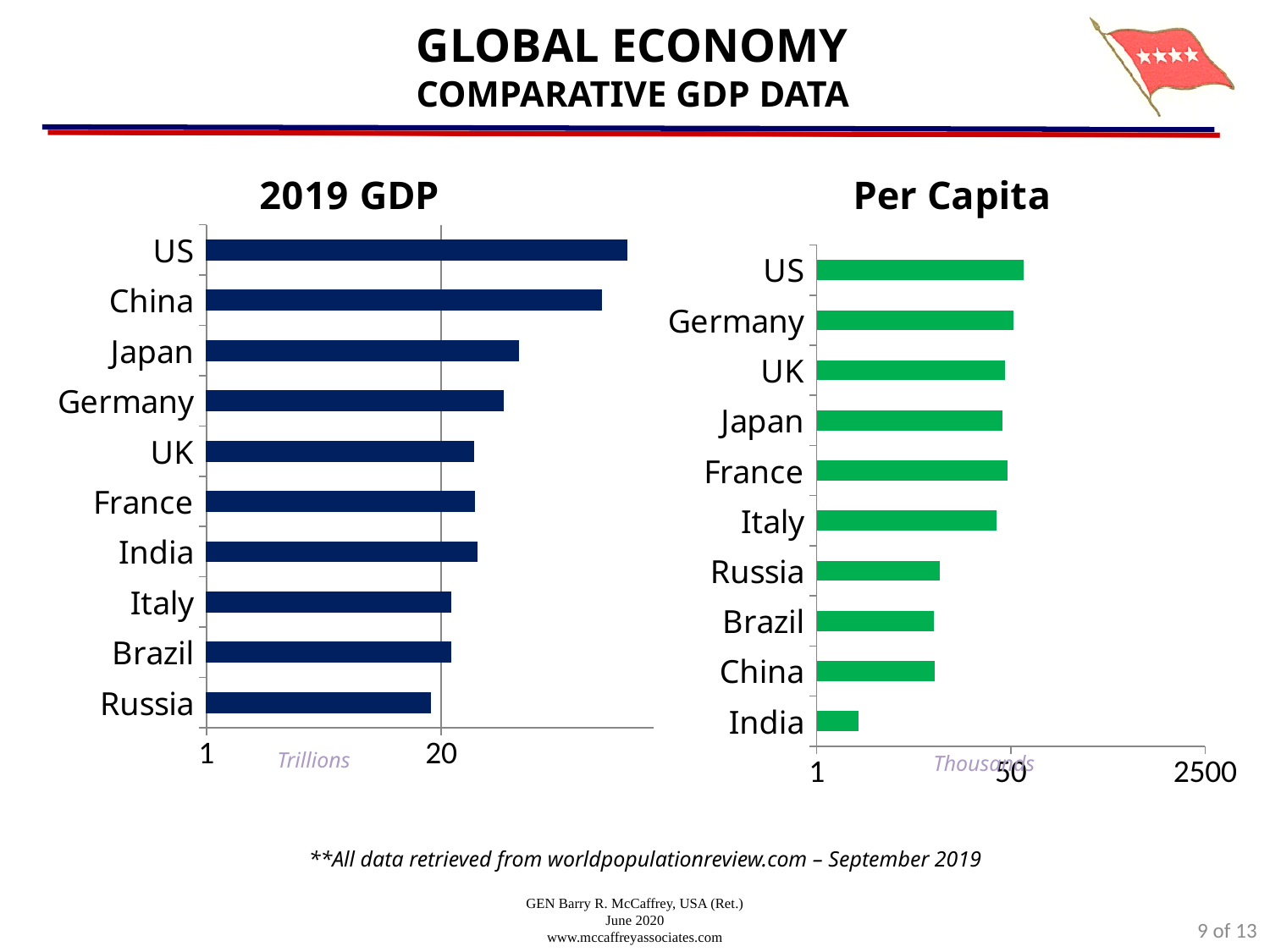
What kind of chart is the 2019 GDP chart? bar chart In the Per Capita chart, which is larger, the value for Russia or for India? Russia In the Per Capita chart, which country has the highest value? US In the 2019 GDP chart, which country has the highest GDP? US In the 2019 GDP chart, is the value for the US greater or less than 20? greater How many countries are shown in the 2019 GDP chart? 10 In the 2019 GDP chart, is the value for Russia greater or less than 20? less In the 2019 GDP chart, which is larger, the GDP of the US or of China? US In the Per Capita chart, which country has the lowest value? India In the 2019 GDP chart, which country has the lowest GDP? Russia In the Per Capita chart, is the value for India greater or less than 50? less What unit label is shown on the x axis of the Per Capita chart? Thousands